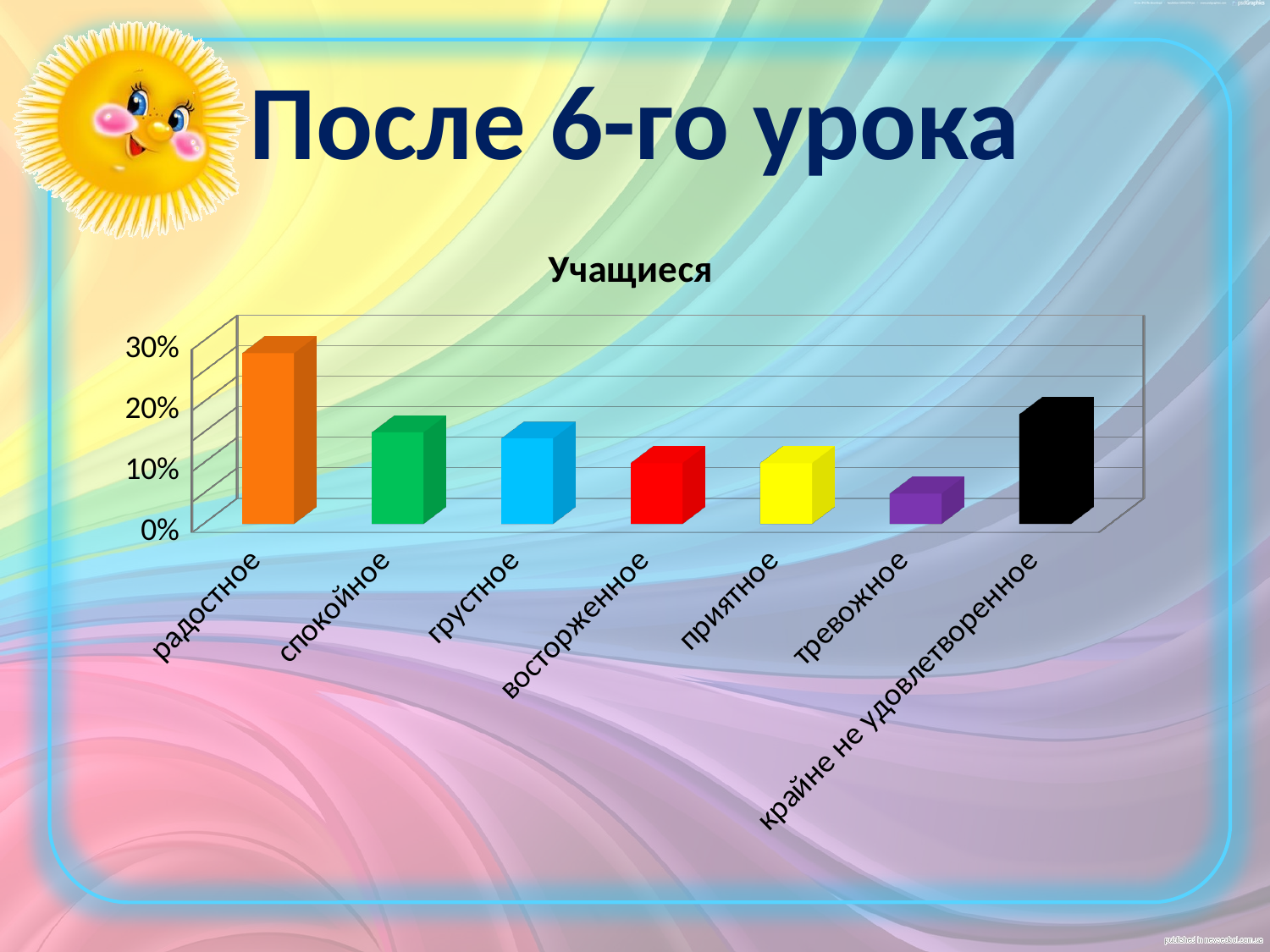
Which is larger, the value for крайне не удовлетворенное or the value for приятное? крайне не удовлетворенное Which category has the lowest value? тревожное Is the value for радостное greater or less than 20%? greater Is the value for тревожное greater or less than 10%? less How many categories are shown on the x axis of the chart? 7 Is the value for спокойное greater or less than 10%? greater What colour is the bar for радостное? orange What kind of chart is shown on the slide? bar chart What is the title of the chart? Учащиеся Which category has the highest value? радостное Which is larger, the value for радостное or the value for спокойное? радостное